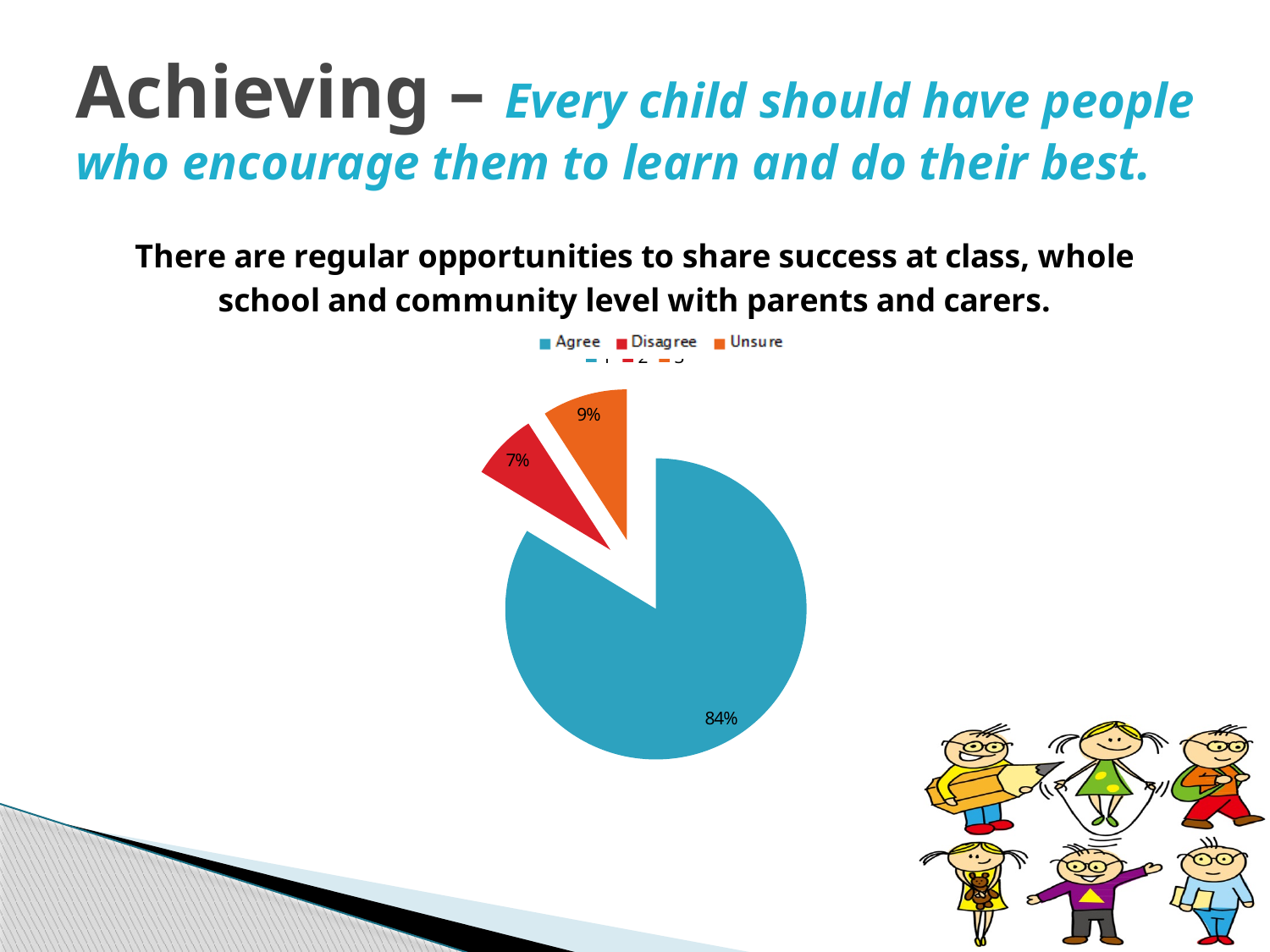
What colour is the Agree slice? blue What percentage of respondents chose Agree? 84% What percentage of respondents chose Unsure? 9% What type of chart is shown on the slide? pie chart What is the difference in percentage points between Unsure and Disagree? 2 How many slices does the pie chart have? 3 Which response has the largest share of the pie? Agree Which is larger, the share for Unsure or the share for Disagree? Unsure How many entries does the legend list? 3 What is the difference in percentage points between Agree and Unsure? 75 What percentage of respondents chose Disagree? 7% Which response has the smallest share of the pie? Disagree